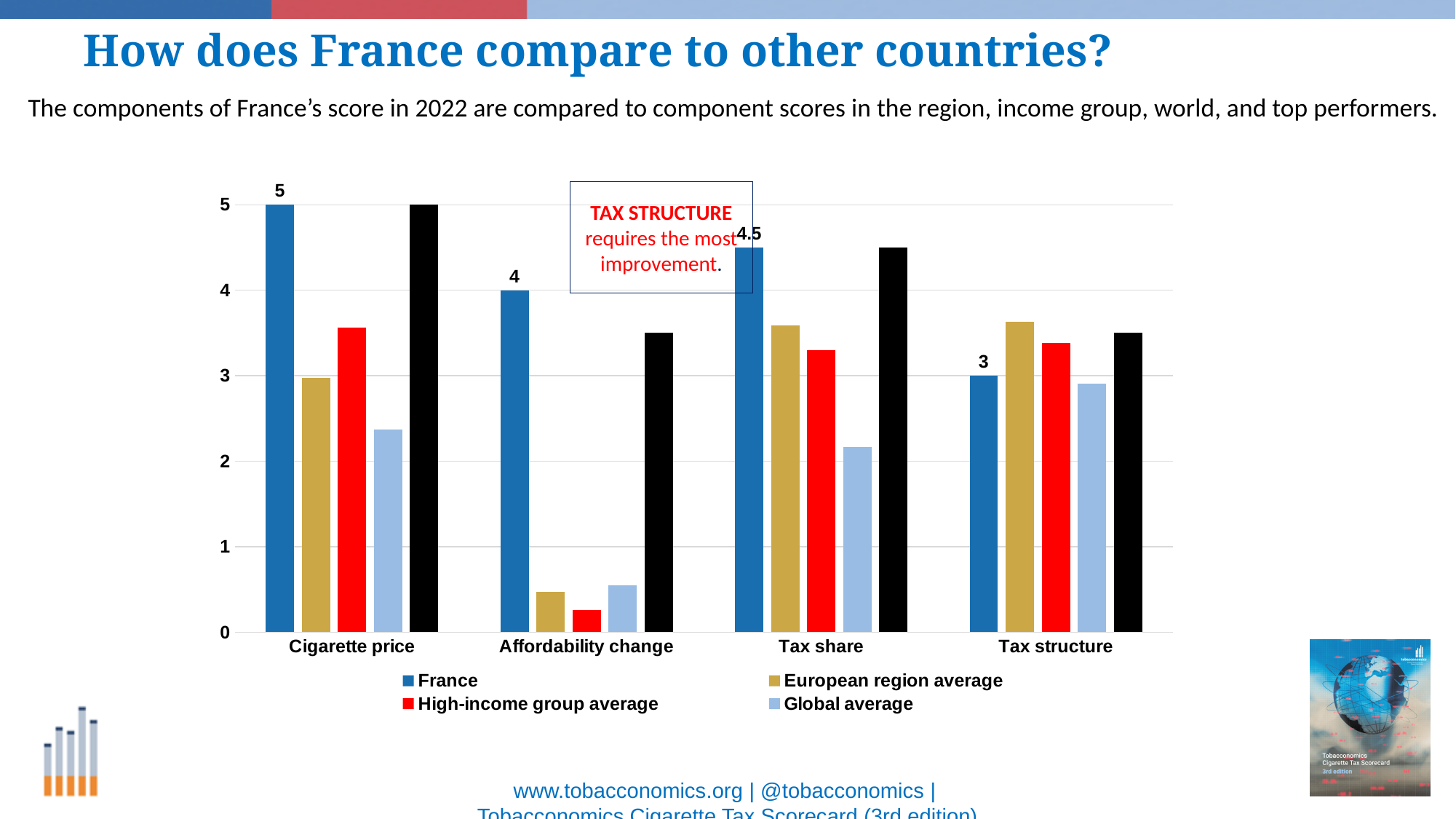
In which component does France have its lowest score? Tax structure Is the Global average for Cigarette price greater or less than 3? less What is the difference between France's Cigarette price score and its Tax structure score? 2 In which component does France have its highest score? Cigarette price How many series does the legend list? 4 What is France's score for Tax share? 4.5 Which is larger for France: the Tax share score or the Affordability change score? Tax share How many components are shown on the x axis? 4 What is France's score for Affordability change? 4 What is France's score for Cigarette price? 5 What is France's score for Tax structure? 3 Is the European region average for Affordability change greater or less than 1? less